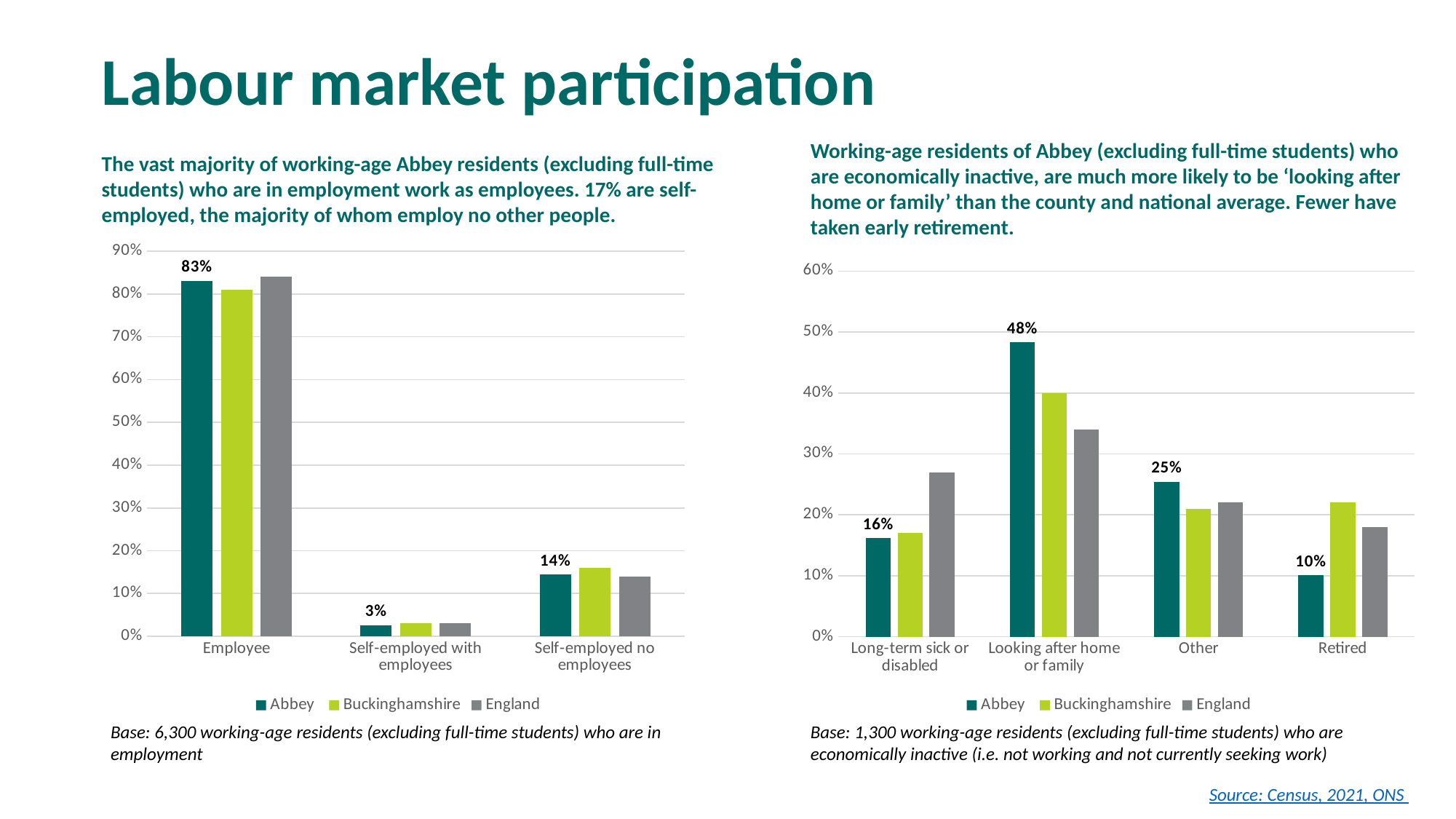
On the left chart, which category has the highest value for Abbey? Employee On the right chart, what is the value for Abbey in the Looking after home or family category? 48% On the left chart, what is the value for Abbey in the Self-employed no employees category? 14% On the right chart, which category has the lowest value for Abbey? Retired What kind of chart is the left chart? Bar chart On the left chart, what is the difference between the Abbey values for Employee and Self-employed no employees? 69 percentage points On the left chart, how many series does the legend list? 3 On the left chart, what is the value for Abbey in the Employee category? 83% On the right chart, is the value for England in the Long-term sick or disabled category greater or less than 20%? greater On the right chart, in the Retired category, which is larger: Abbey or Buckinghamshire? Buckinghamshire On the right chart, what is the value for Abbey in the Retired category? 10% On the right chart, how many categories are shown on the x axis? 4